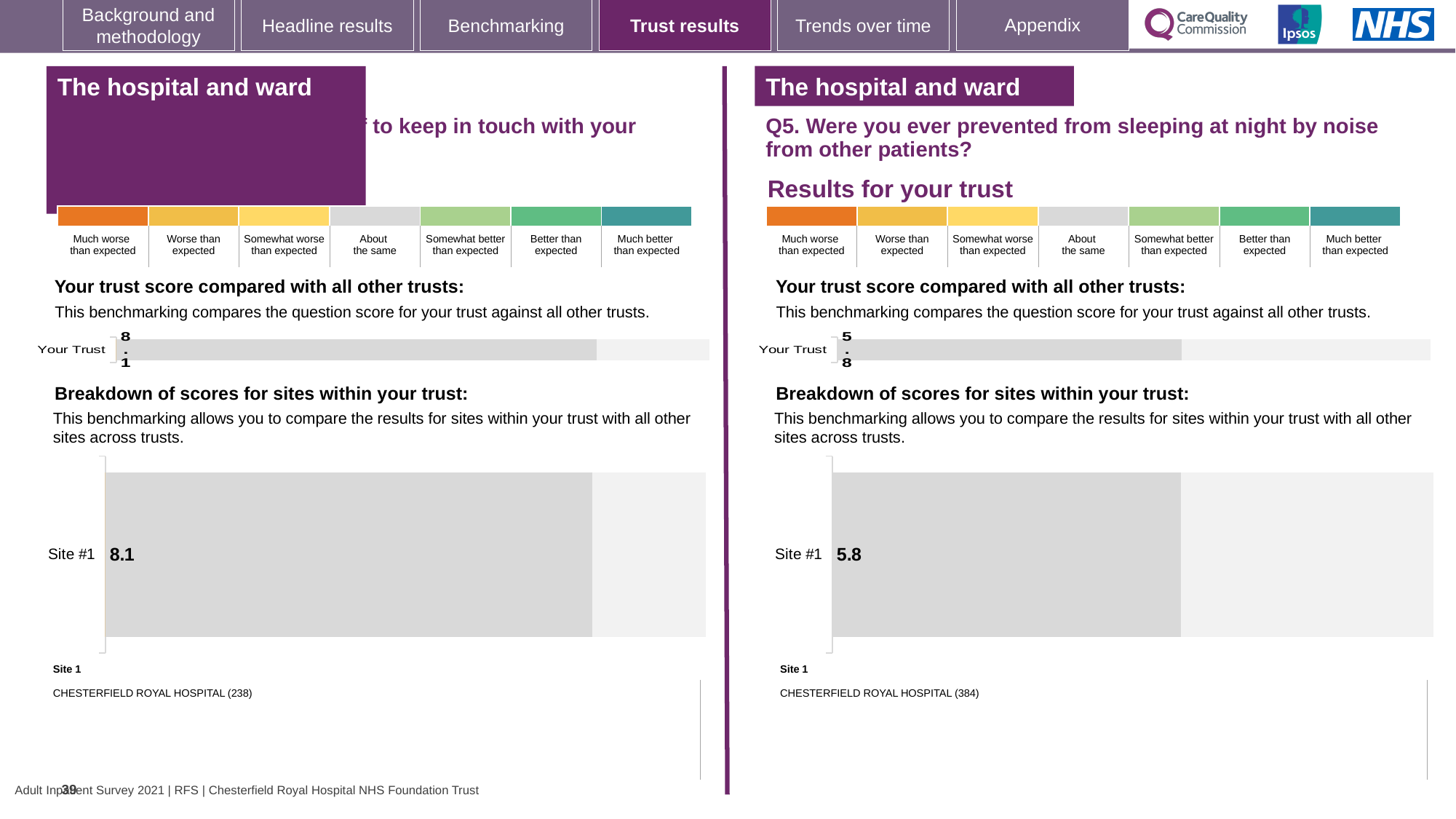
On the right-hand side of the slide (Q5, prevented from sleeping at night by noise from other patients), what is the score shown for Your Trust? 5.8 Which is larger: the Site #1 score on the left-hand chart or the Site #1 score on the right-hand chart (Q5)? Left-hand chart (8.1) On the left-hand side of the slide, which site is listed as Site 1 below the chart? CHESTERFIELD ROYAL HOSPITAL (238) How many sites are shown in the breakdown of scores chart on the left-hand side of the slide? 1 On the left-hand side of the slide, what is the score shown for Site #1 in the breakdown of scores for sites within your trust? 8.1 Is the Your Trust score on the right-hand side of the slide (Q5) the same as the Site #1 score on that side? Yes, both are 5.8 What is the difference between the Site #1 score on the left-hand chart (8.1) and the Site #1 score on the right-hand chart (5.8)? 2.3 What kind of chart is used to show the Site #1 score on the right-hand side of the slide (Q5)? Bar chart On the right-hand side of the slide (Q5), which site is listed as Site 1 below the chart? CHESTERFIELD ROYAL HOSPITAL (384) On the left-hand side of the slide, what is the score shown for Your Trust? 8.1 How many sites are shown in the breakdown of scores chart on the right-hand side of the slide (Q5)? 1 On the right-hand side of the slide (Q5), what is the score shown for Site #1 in the breakdown of scores for sites within your trust? 5.8